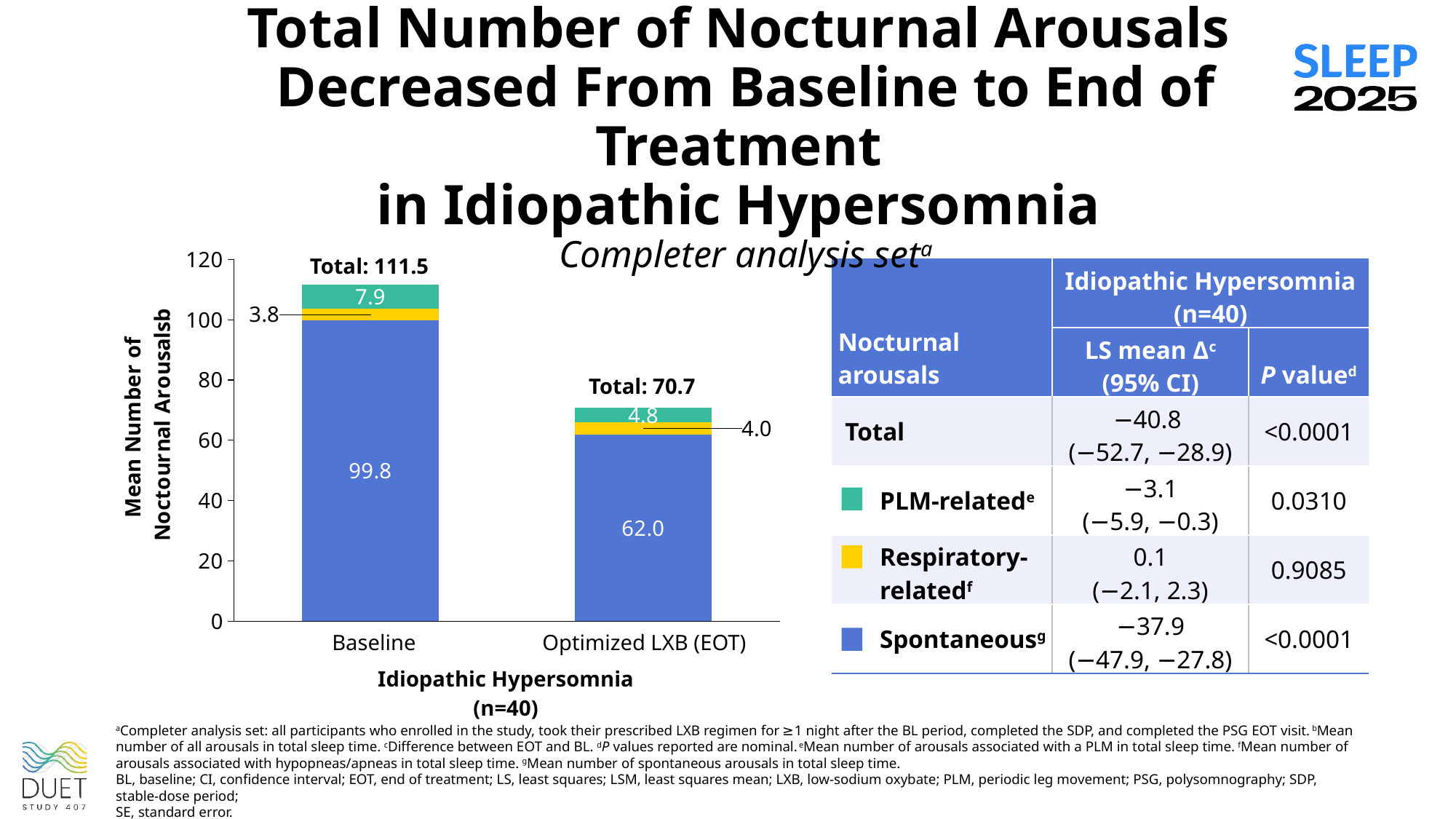
What is the difference in total nocturnal arousals between Baseline and Optimized LXB (EOT)? 40.8 What is the mean number of PLM-related nocturnal arousals at Baseline? 7.9 What is the total mean number of nocturnal arousals for the Optimized LXB (EOT) bar? 70.7 Which bar has the higher total number of nocturnal arousals, Baseline or Optimized LXB (EOT)? Baseline How many series (arousal types) are stacked in each bar? 3 What is the total mean number of nocturnal arousals for the Baseline bar? 111.5 What is the mean number of spontaneous nocturnal arousals at Optimized LXB (EOT)? 62.0 What type of chart is shown on the slide? Stacked bar chart What is the mean number of respiratory-related nocturnal arousals at Optimized LXB (EOT)? 4.0 How many bars (categories) are shown on the x axis of the chart? 2 What is the mean number of spontaneous nocturnal arousals at Baseline? 99.8 Is the total for the Optimized LXB (EOT) bar greater or less than 80? less